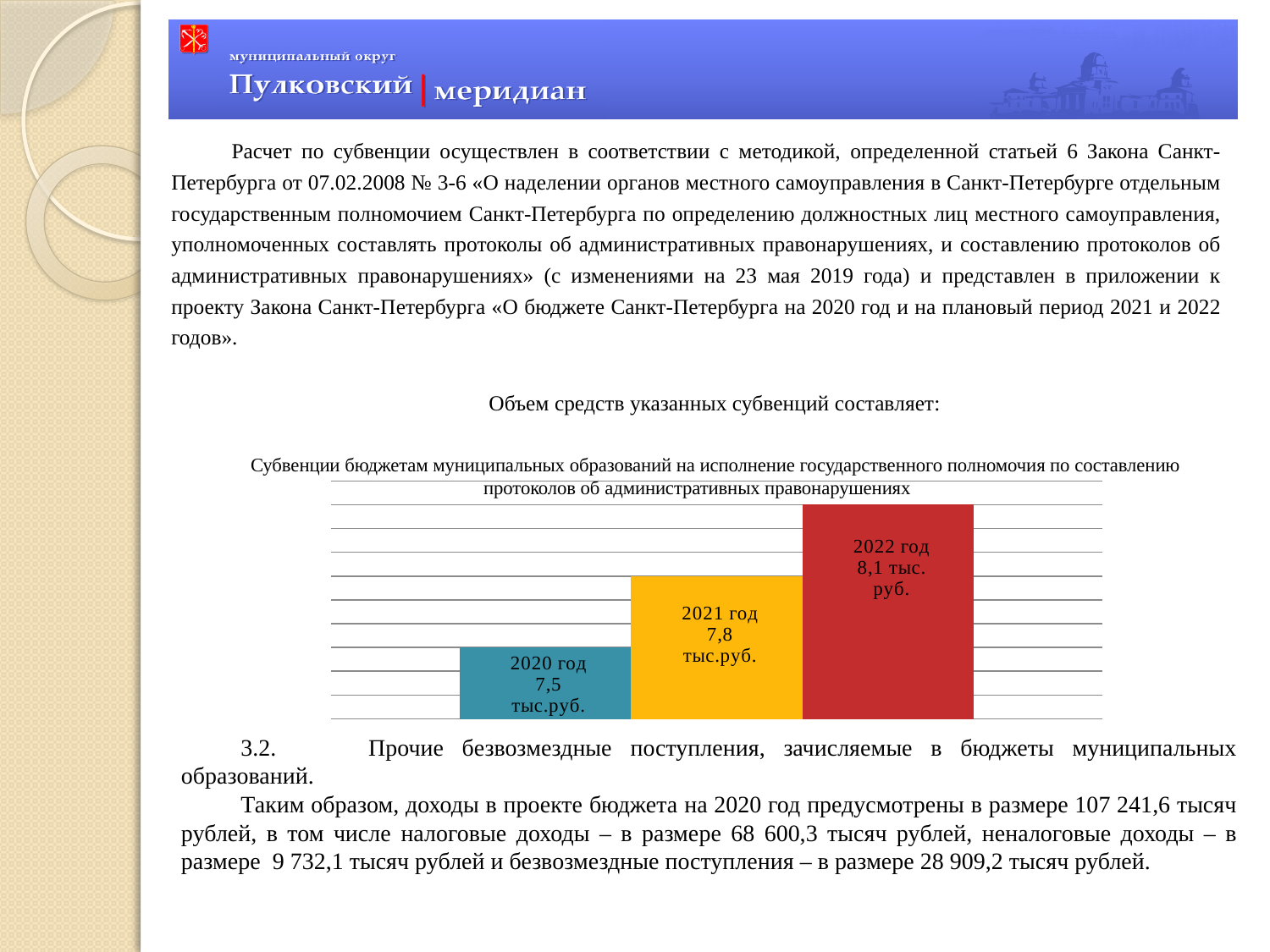
What colour is the bar for 2021 год? Yellow What kind of chart is shown on the slide? Bar chart Which year has the lowest value in the chart? 2020 год What is the difference between the values for 2022 год and 2020 год? 0,6 тыс.руб. Do the values rise or fall from 2020 год to 2022 год? Rise What is the difference between the values for 2021 год and 2020 год? 0,3 тыс.руб. Which year has the highest value in the chart? 2022 год What is the value shown for 2020 год? 7,5 тыс.руб. How many bars are shown in the chart? 3 What is the value shown for 2021 год? 7,8 тыс.руб. What is the value shown for 2022 год? 8,1 тыс.руб. Which is larger, the value for 2021 год or the value for 2022 год? 2022 год